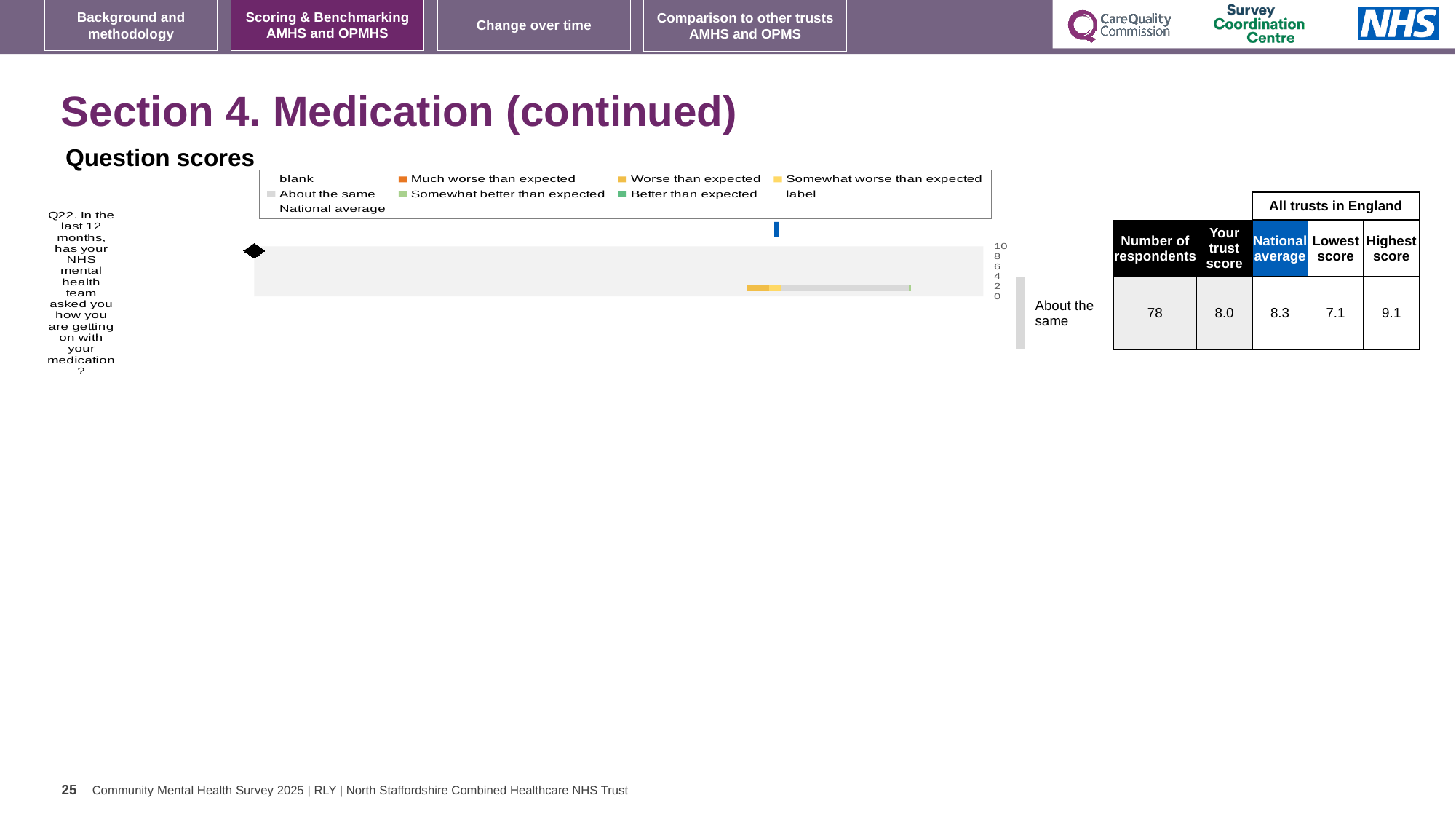
What is the difference between the highest score and the lowest score for Q22? 2.0 What benchmark category is shown for Q22 in the Question scores chart? About the same How many questions are plotted in the Question scores chart? 1 What is the national average for Q22 shown next to the Question scores chart? 8.3 Which question is plotted in the Question scores chart? Q22 What kind of chart is shown under 'Question scores'? bar chart What is the lowest score among all trusts in England for Q22? 7.1 What is the trust score for Q22 shown next to the Question scores chart? 8.0 How many entries does the legend of the Question scores chart list? 9 Which is larger for Q22, the trust score or the national average? national average How many respondents answered Q22? 78 What is the highest score among all trusts in England for Q22? 9.1